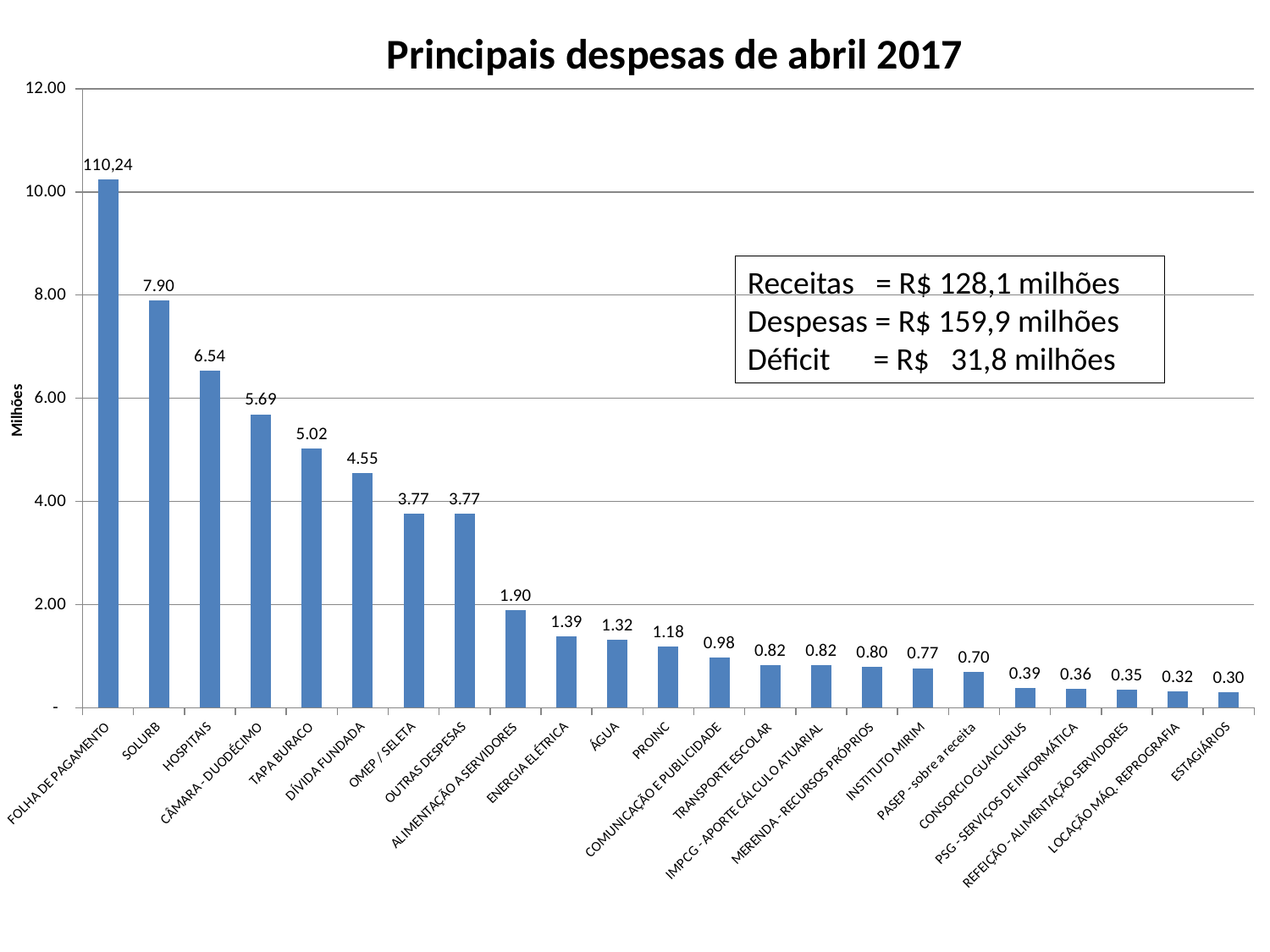
Which category has the highest value? FOLHA DE PAGAMENTO Which is larger, the value for TAPA BURACO or the value for DÍVIDA FUNDADA? TAPA BURACO What is the value for ENERGIA ELÉTRICA? 1.39 What type of chart is shown on the slide? Bar chart What is the value for ESTAGIÁRIOS? 0.30 What is the difference between the values for SOLURB and HOSPITAIS? 1.36 What is the title of the chart? Principais despesas de abril 2017 What is the value for SOLURB? 7.90 Is the value for CÂMARA - DUODÉCIMO greater or less than 6.00? less What is the value for TAPA BURACO? 5.02 Do the values rise or fall moving from left to right along the x axis? Fall What is the value for HOSPITAIS? 6.54